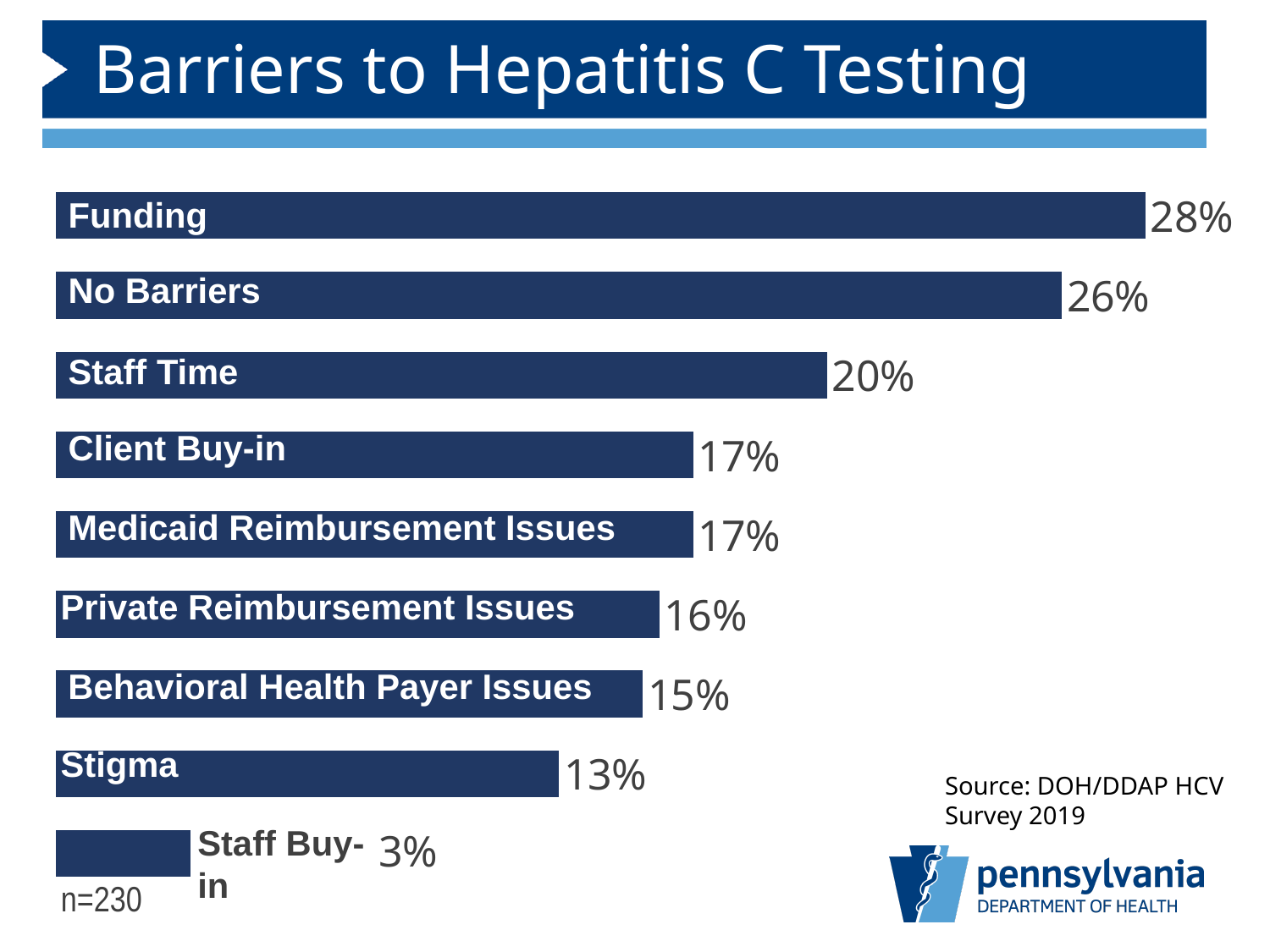
What is the sample size (n) noted on the chart? n=230 Which category has the lowest percentage? Staff Buy-in What percentage of respondents cited Funding as a barrier to Hepatitis C testing? 28% Which barrier has the highest percentage? Funding Which is larger, Private Reimbursement Issues or Behavioral Health Payer Issues? Private Reimbursement Issues What is the value for Staff Buy-in? 3% How many categories are shown in the chart? 9 What is the difference between the Funding value and the No Barriers value? 2% What is the value shown for Staff Time? 20% What kind of chart is shown on the slide? Bar chart What percentage is shown for Stigma? 13% What is the difference between Staff Time and Stigma? 7%